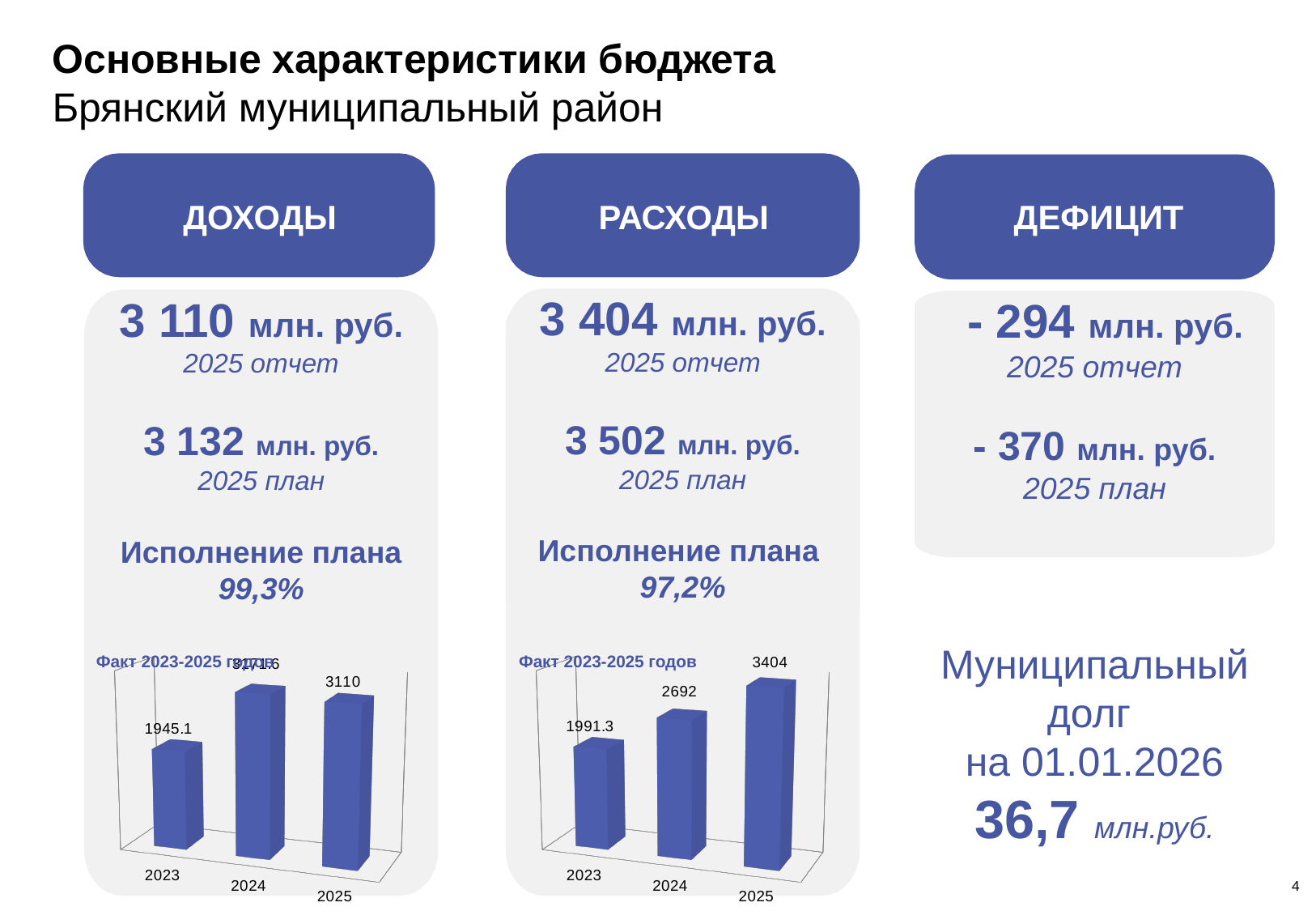
In the middle chart (under РАСХОДЫ), do the values rise or fall from 2023 to 2025? rise In the middle chart (under РАСХОДЫ), what is the value for 2024? 2692 In the middle chart (under РАСХОДЫ), what is the value for 2023? 1991.3 In the left chart (under ДОХОДЫ), which year has the lowest value? 2023 In the left chart (under ДОХОДЫ), what is the value for 2025? 3110 In the left chart (under ДОХОДЫ), which is larger: the value for 2023 or the value for 2025? 2025 How many bars are shown in the left chart (under ДОХОДЫ)? 3 What kind of chart is the chart under ДОХОДЫ (left chart)? bar chart In the middle chart (under РАСХОДЫ), what is the value for 2025? 3404 In the middle chart (under РАСХОДЫ), which year has the highest value? 2025 In the middle chart (under РАСХОДЫ), what is the difference between the 2025 and 2024 values? 712 In the left chart (under ДОХОДЫ), what is the value for 2023? 1945.1